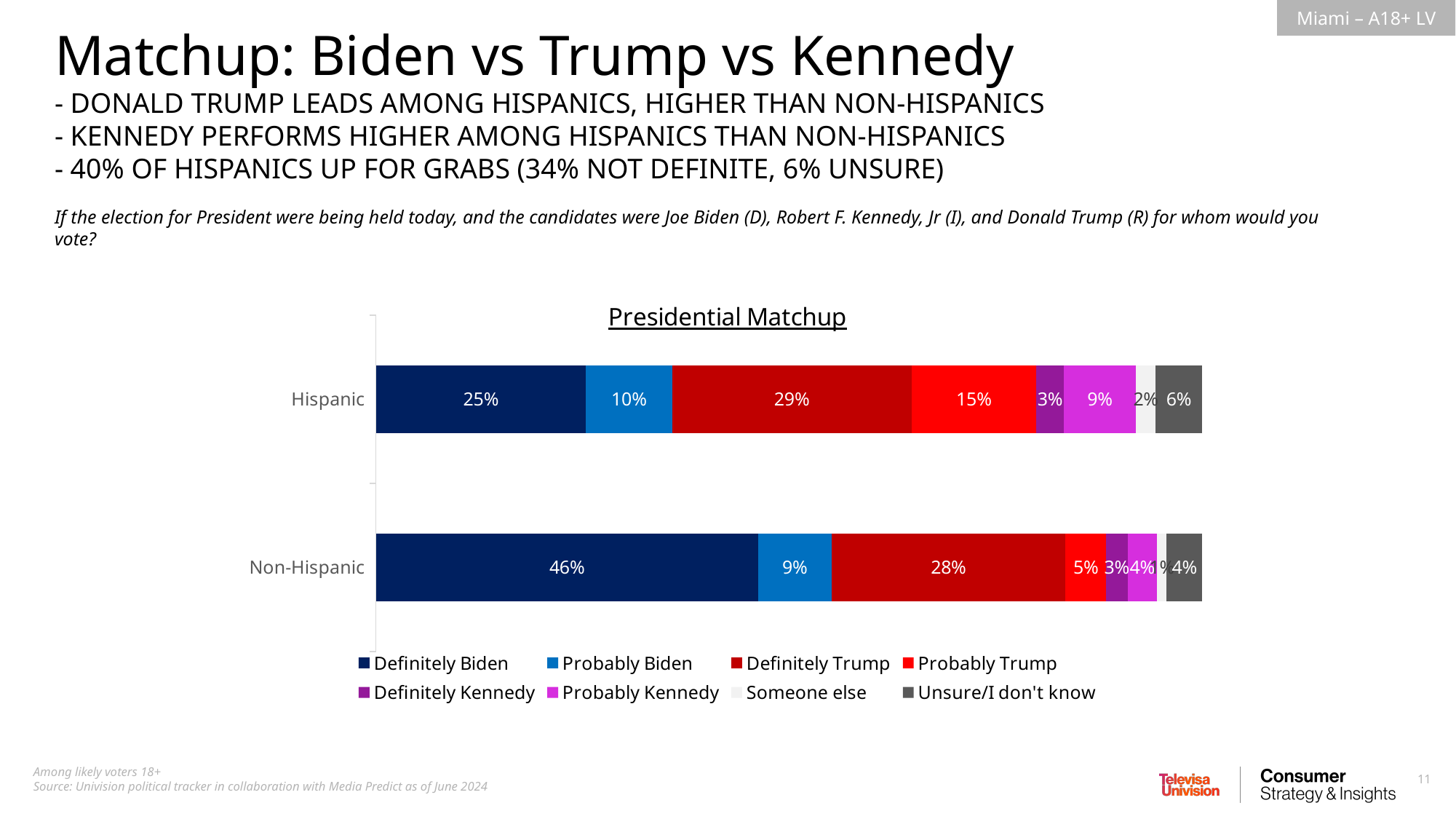
What is the Unsure/I don't know value for Hispanic? 6% What is the difference between the Definitely Biden values for Non-Hispanic and Hispanic? 21% How many categories are shown on the chart? 2 What is the Probably Trump value for Hispanic? 15% What is the difference between the Probably Kennedy values for Hispanic and Non-Hispanic? 5% How many series does the chart legend list? 8 What type of chart is shown on the slide? stacked bar chart What is the title of the chart? Presidential Matchup Which series has the largest value in the Hispanic bar? Definitely Trump What is the Definitely Biden value for Hispanic? 25% What is the Definitely Trump value for Non-Hispanic? 28% Which category has the higher Definitely Biden value, Hispanic or Non-Hispanic? Non-Hispanic